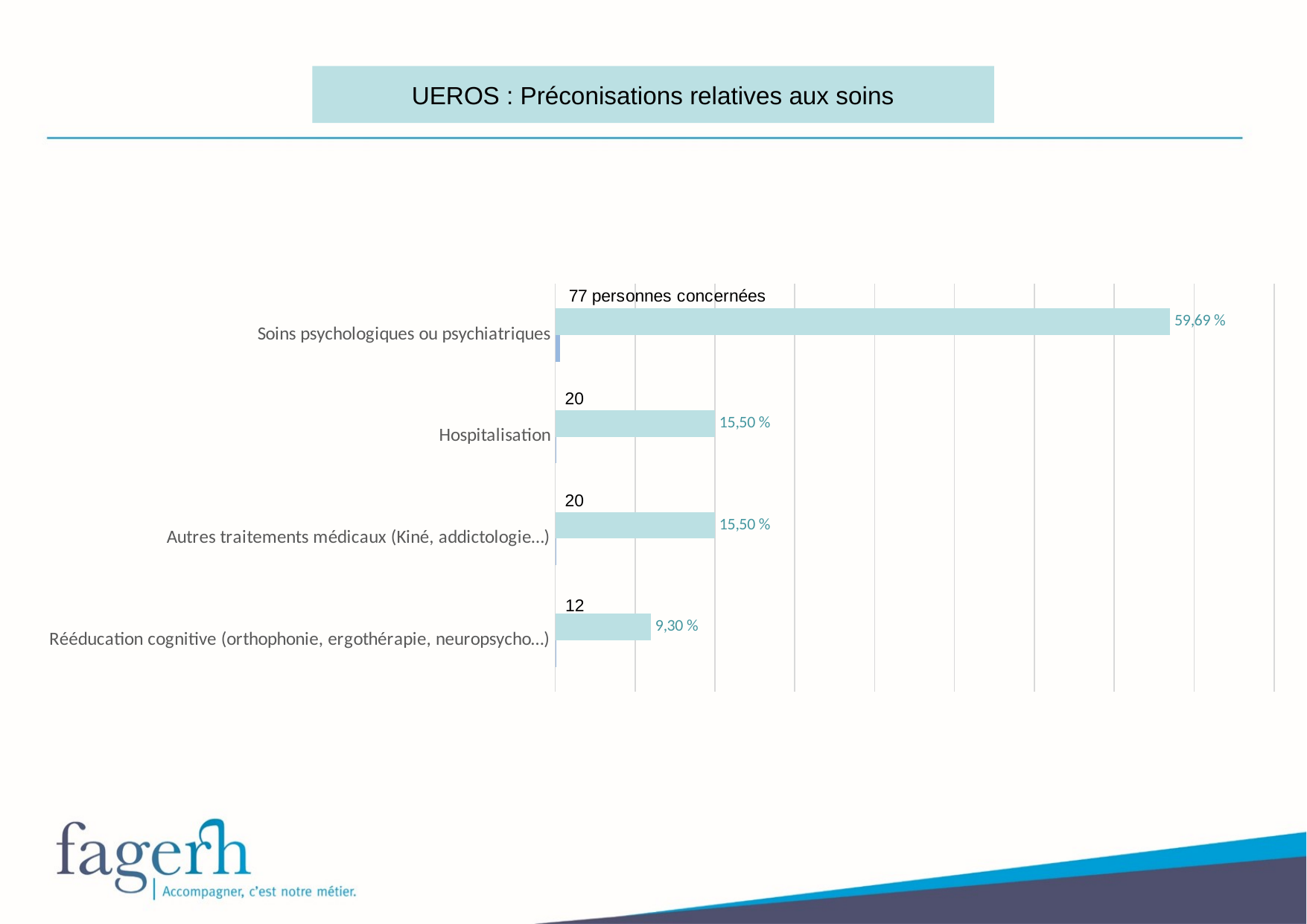
What percentage is shown for Soins psychologiques ou psychiatriques? 59,69 % What is the difference in percentage points between Soins psychologiques ou psychiatriques and Hospitalisation? 44,19 What is the title of the slide? UEROS : Préconisations relatives aux soins Which category has the lowest percentage? Rééducation cognitive (orthophonie, ergothérapie, neuropsycho…) What percentage is shown for Rééducation cognitive (orthophonie, ergothérapie, neuropsycho…)? 9,30 % How many categories are shown in the chart? 4 Which category has the highest percentage? Soins psychologiques ou psychiatriques What percentage is shown for Hospitalisation? 15,50 % How many people are concerned by Autres traitements médicaux (Kiné, addictologie…)? 20 Which is larger, the percentage for Hospitalisation or for Rééducation cognitive? Hospitalisation What type of chart is shown on the slide? Bar chart How many people are concerned by Soins psychologiques ou psychiatriques? 77